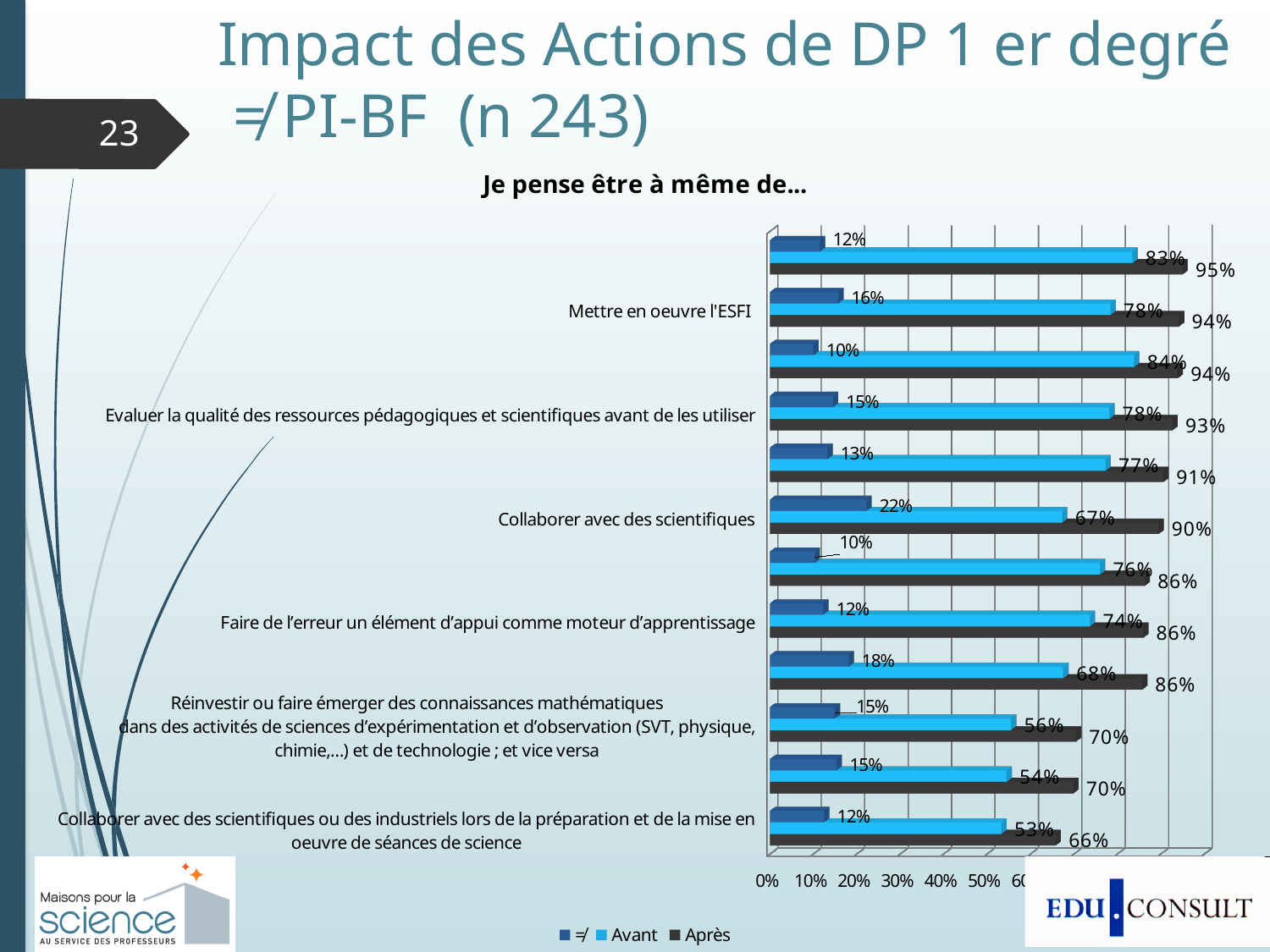
What are the series names listed in the chart legend? =/, Avant, Après Which has the larger 'Avant' value: 'Collaborer avec des scientifiques' or 'Faire de l'erreur un élément d'appui comme moteur d'apprentissage'? Faire de l'erreur un élément d'appui comme moteur d'apprentissage What is the 'Après' value for 'Collaborer avec des scientifiques ou des industriels lors de la préparation et de la mise en oeuvre de séances de science'? 66% What is the highest 'Après' value shown in the chart? 95% What is the 'Avant' value for 'Réinvestir ou faire émerger des connaissances mathématiques dans des activités de sciences d'expérimentation et d'observation (SVT, physique, chimie,…) et de technologie ; et vice versa'? 56% What is the '=/' value for 'Collaborer avec des scientifiques'? 22% What is the 'Après' value for 'Mettre en oeuvre l'ESFI'? 94% What is the difference between the 'Après' and 'Avant' values for 'Mettre en oeuvre l'ESFI'? 16 percentage points What is the title shown above the chart? Je pense être à même de… How many series does the chart legend list? 3 What is the 'Avant' value for 'Collaborer avec des scientifiques'? 67% What type of chart is shown on the slide? bar chart